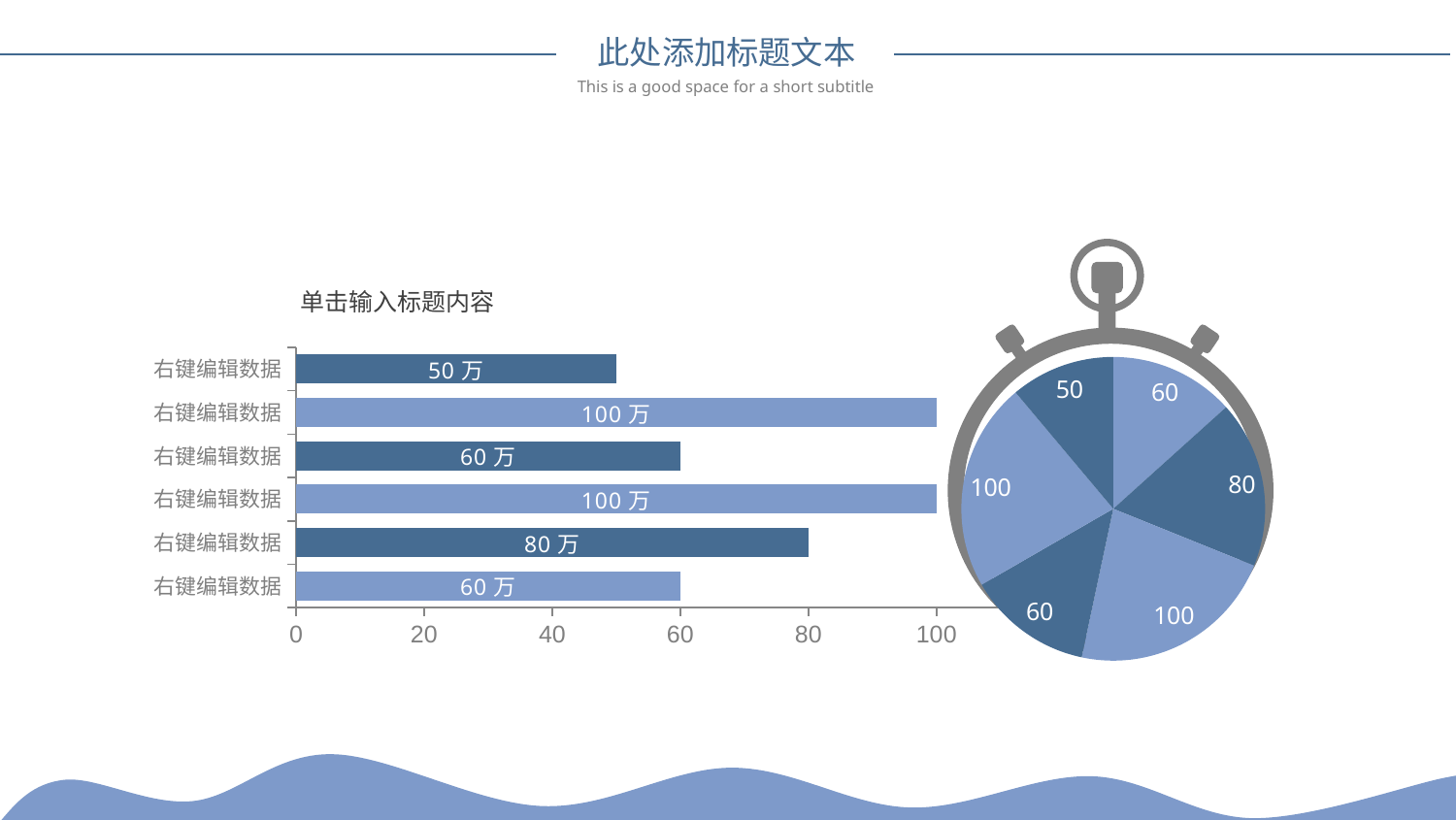
In the bar chart titled 单击输入标题内容, what is the value of the top (first) bar? 50 万 In the bar chart titled 单击输入标题内容, what is the value of the fifth bar from the top? 80 万 What type of chart is shown on the right side of the slide inside the stopwatch graphic? pie chart In the bar chart titled 单击输入标题内容, what is the largest bar value? 100 万 In the bar chart titled 单击输入标题内容, what is the smallest bar value? 50 万 What is the smallest slice value in the pie chart on the right? 50 What type of chart is the left chart titled 单击输入标题内容? bar chart In the bar chart titled 单击输入标题内容, which is larger: the third bar or the fifth bar? the fifth bar (80 万) In the bar chart titled 单击输入标题内容, what is the difference between the second bar and the first bar? 50 万 How many bars are in the bar chart titled 单击输入标题内容? 6 In the bar chart titled 单击输入标题内容, what is the value of the bottom bar? 60 万 How many slices does the pie chart on the right have? 6